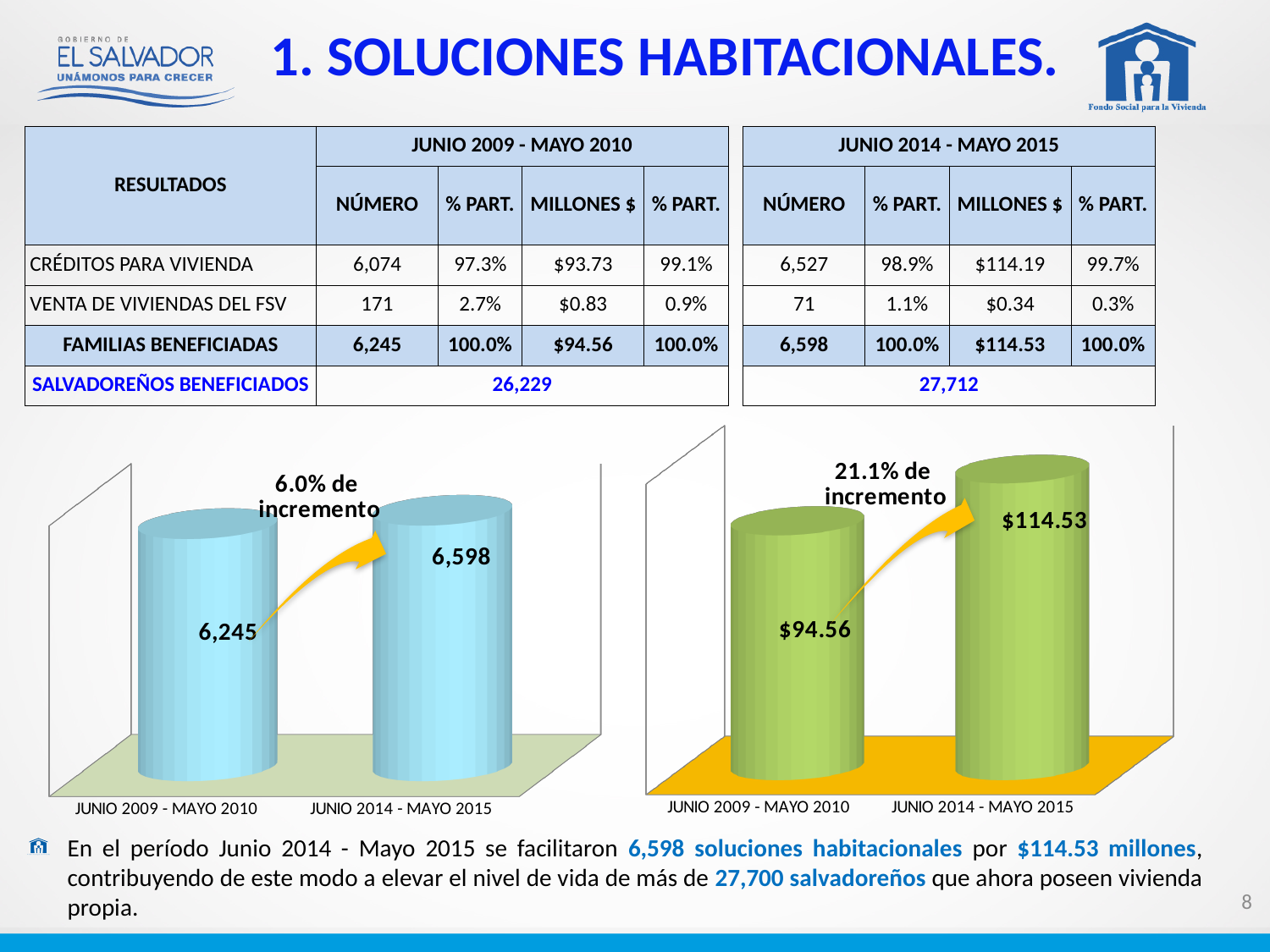
In the left chart, what is the value for JUNIO 2014 - MAYO 2015? 6,598 In the right chart, what is the value for JUNIO 2014 - MAYO 2015? $114.53 In the left chart, what is the difference between the values for JUNIO 2014 - MAYO 2015 and JUNIO 2009 - MAYO 2010? 353 In the left chart, which period has the higher value? JUNIO 2014 - MAYO 2015 In the right chart, what is the value for JUNIO 2009 - MAYO 2010? $94.56 How many categories are shown in the left chart? 2 In the right chart, what is the difference between the values for JUNIO 2014 - MAYO 2015 and JUNIO 2009 - MAYO 2010? $19.97 What percentage increase is annotated on the right chart? 21.1% de incremento In the right chart, is the value for JUNIO 2014 - MAYO 2015 larger or smaller than the value for JUNIO 2009 - MAYO 2010? larger In the left chart, what is the value for JUNIO 2009 - MAYO 2010? 6,245 In the right chart, which period has the lower value? JUNIO 2009 - MAYO 2010 What kind of chart is the right chart? bar chart